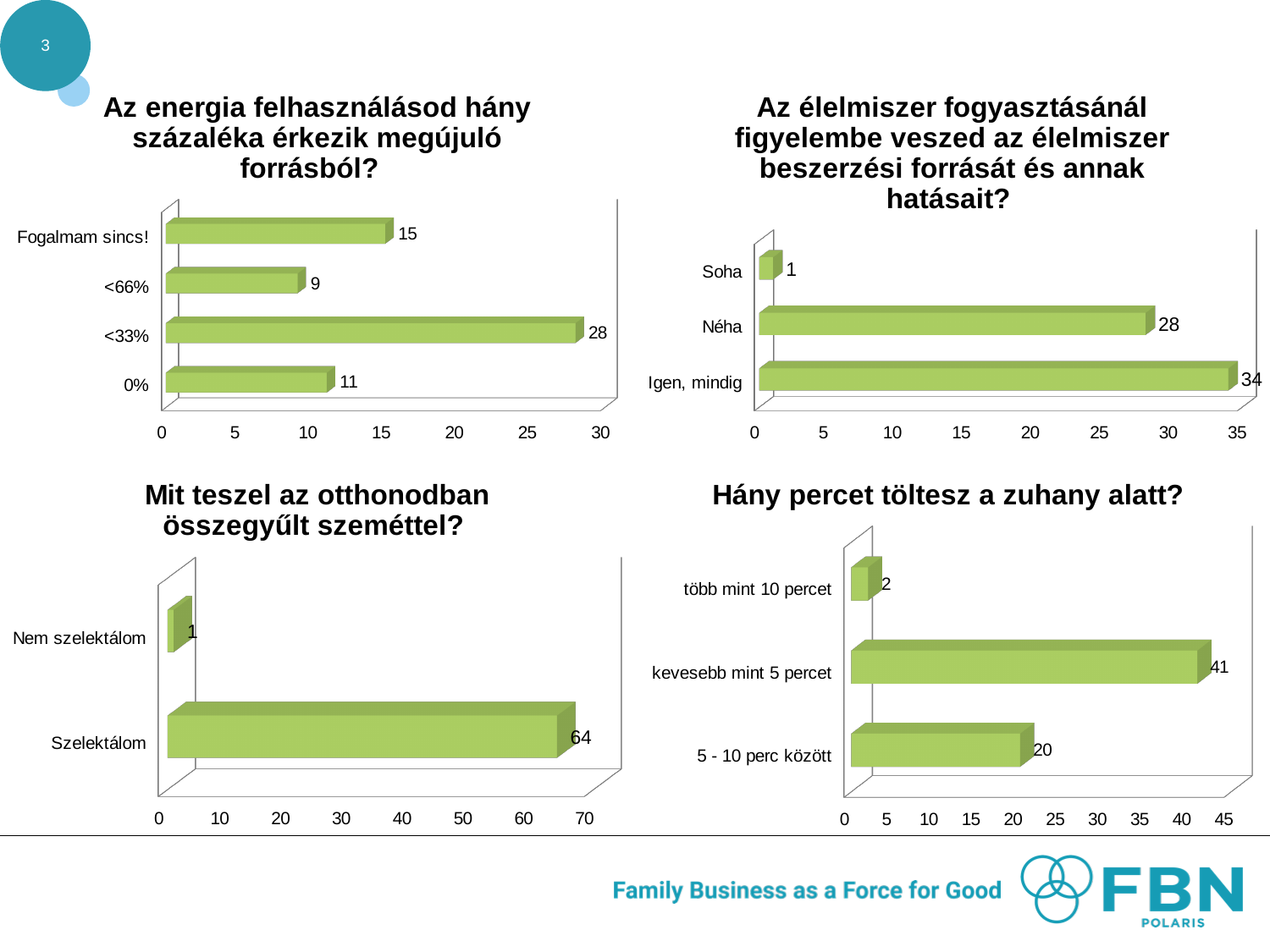
In the bottom-left chart ("Mit teszel az otthonodban összegyűlt szeméttel?"), what is the value for "Szelektálom"? 64 In the top-left chart ("Az energia felhasználásod hány százaléka érkezik megújuló forrásból?"), which category has the lowest value? <66% What type of chart is the bottom-left chart ("Mit teszel az otthonodban összegyűlt szeméttel?")? Bar chart In the bottom-right chart ("Hány percet töltesz a zuhany alatt?"), which is larger: "kevesebb mint 5 percet" or "több mint 10 percet"? kevesebb mint 5 percet In the top-right chart ("Az élelmiszer fogyasztásánál figyelembe veszed..."), what is the value for "Néha"? 28 In the bottom-left chart ("Mit teszel az otthonodban összegyűlt szeméttel?"), what is the difference between "Szelektálom" and "Nem szelektálom"? 63 In the top-left chart ("Az energia felhasználásod hány százaléka érkezik megújuló forrásból?"), what is the value for "<33%"? 28 In the top-left chart ("Az energia felhasználásod hány százaléka érkezik megújuló forrásból?"), what is the difference between "Fogalmam sincs!" and "0%"? 4 In the bottom-right chart ("Hány percet töltesz a zuhany alatt?"), is the value for "kevesebb mint 5 percet" greater or less than 35? greater In the bottom-right chart ("Hány percet töltesz a zuhany alatt?"), what is the value for "5 - 10 perc között"? 20 In the top-right chart ("Az élelmiszer fogyasztásánál figyelembe veszed..."), how many categories are shown? 3 In the top-right chart ("Az élelmiszer fogyasztásánál figyelembe veszed..."), which category has the highest value? Igen, mindig